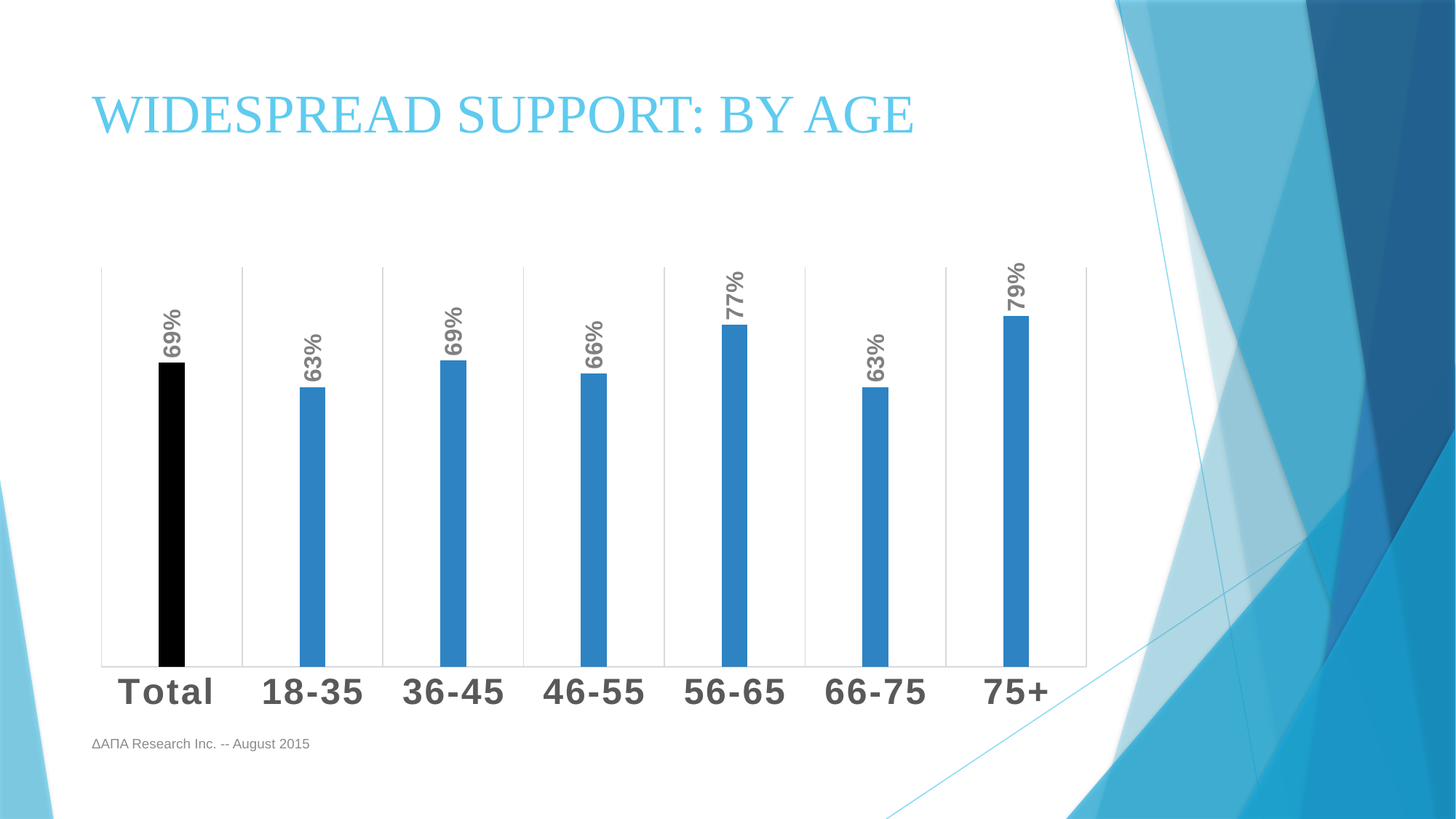
What kind of chart is shown on the slide? Bar chart How many bars are shown in the chart? 7 What is the difference between the values for 56-65 and 46-55? 11% Which bar is coloured black rather than blue? Total What is the value for the 56-65 age group? 77% What is the value for the Total bar? 69% What is the title of the slide? WIDESPREAD SUPPORT: BY AGE What is the value for the 18-35 age group? 63% Which age group has the highest value? 75+ Which is larger, the value for 36-45 or the value for 46-55? 36-45 What is the difference between the values for 75+ and 18-35? 16% What is the value for the 75+ age group? 79%